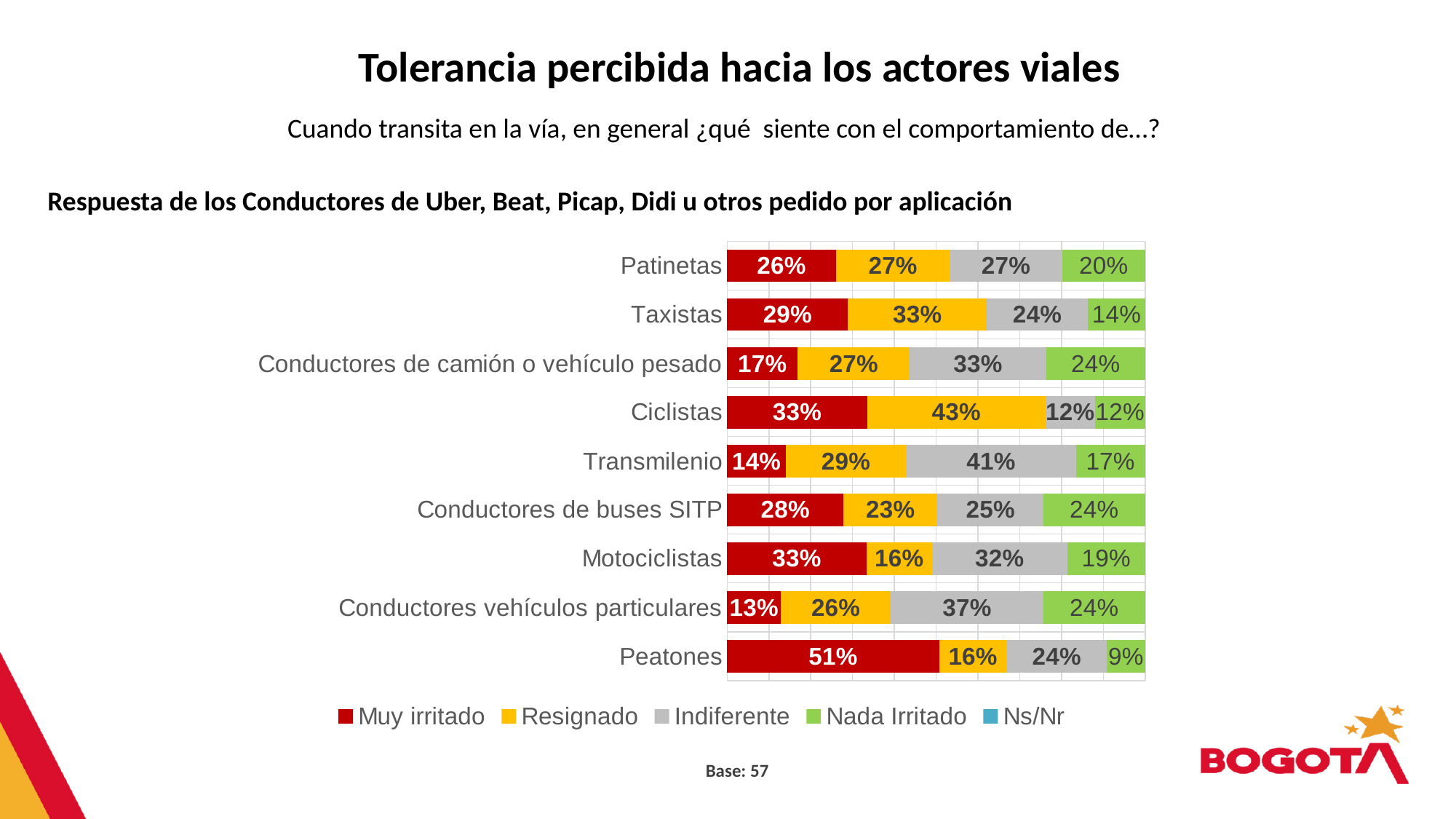
How many series does the legend list? 5 What is the difference between the 'Muy irritado' values for Peatones and Transmilenio? 37% Which category has the highest 'Muy irritado' value? Peatones What is the 'Resignado' value for Ciclistas? 43% How many categories are shown on the chart? 9 What is the 'Indiferente' value for Transmilenio? 41% What is the 'Muy irritado' value for Peatones? 51% What is the total of the Ciclistas bar? 100% What kind of chart is shown on the slide? Stacked bar chart Which category has the lowest 'Muy irritado' value? Conductores vehículos particulares What is the 'Nada Irritado' value for Taxistas? 14% Which is larger: the 'Resignado' value for Taxistas or for Motociclistas? Taxistas